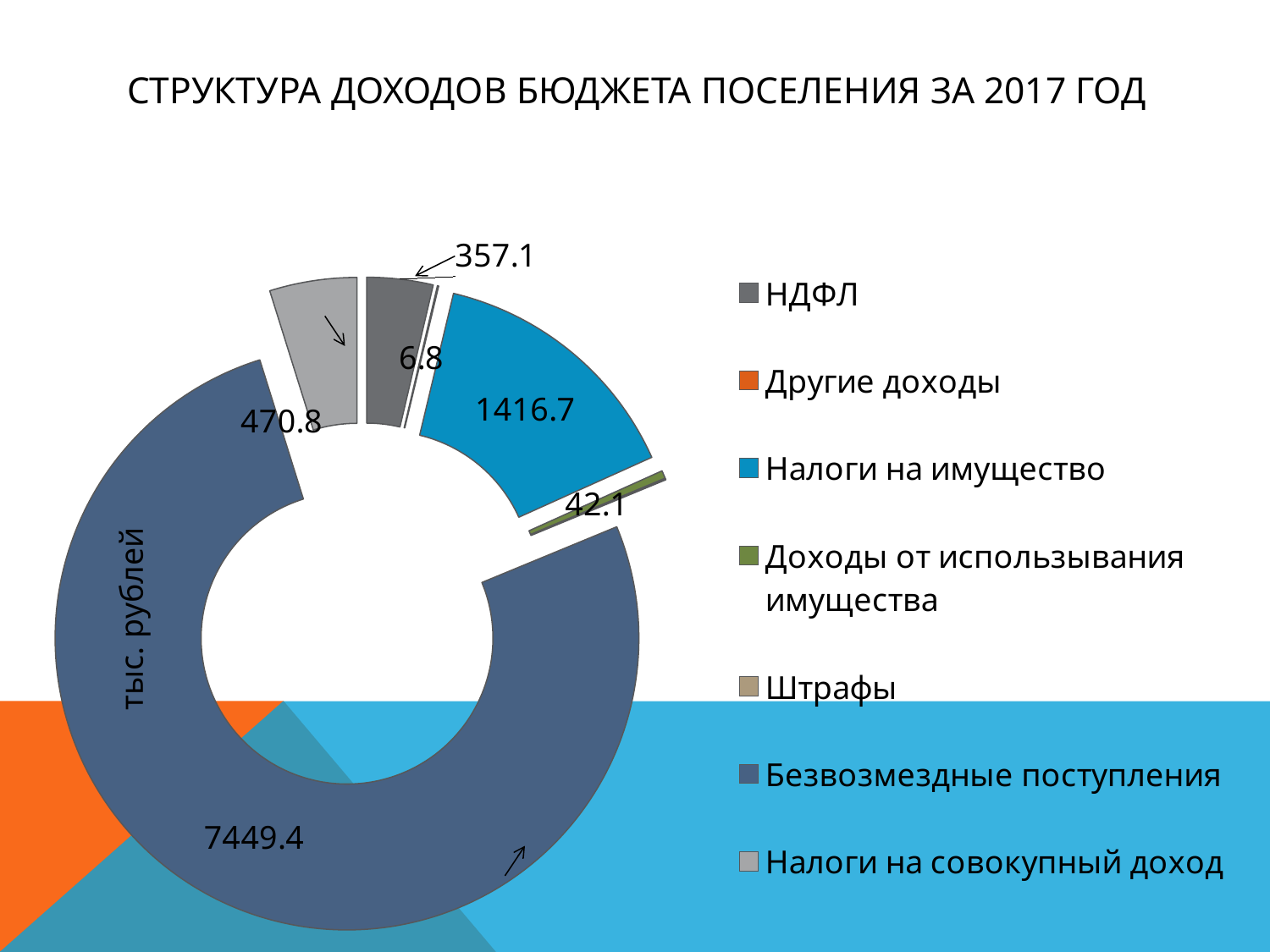
What is the value for НДФЛ? 357.1 What unit is indicated on the chart? тыс. рублей What is the value for Налоги на совокупный доход? 470.8 What is the difference between Безвозмездные поступления and Налоги на имущество? 6032.7 What is the value for Налоги на имущество? 1416.7 How many categories does the legend list? 7 Which is larger, Налоги на совокупный доход or НДФЛ? Налоги на совокупный доход Which category has the highest value? Безвозмездные поступления What is the value for Доходы от использывания имущества? 42.1 What is the value for Безвозмездные поступления? 7449.4 What is the difference between Налоги на имущество and Налоги на совокупный доход? 945.9 What kind of chart is shown on the slide? doughnut chart